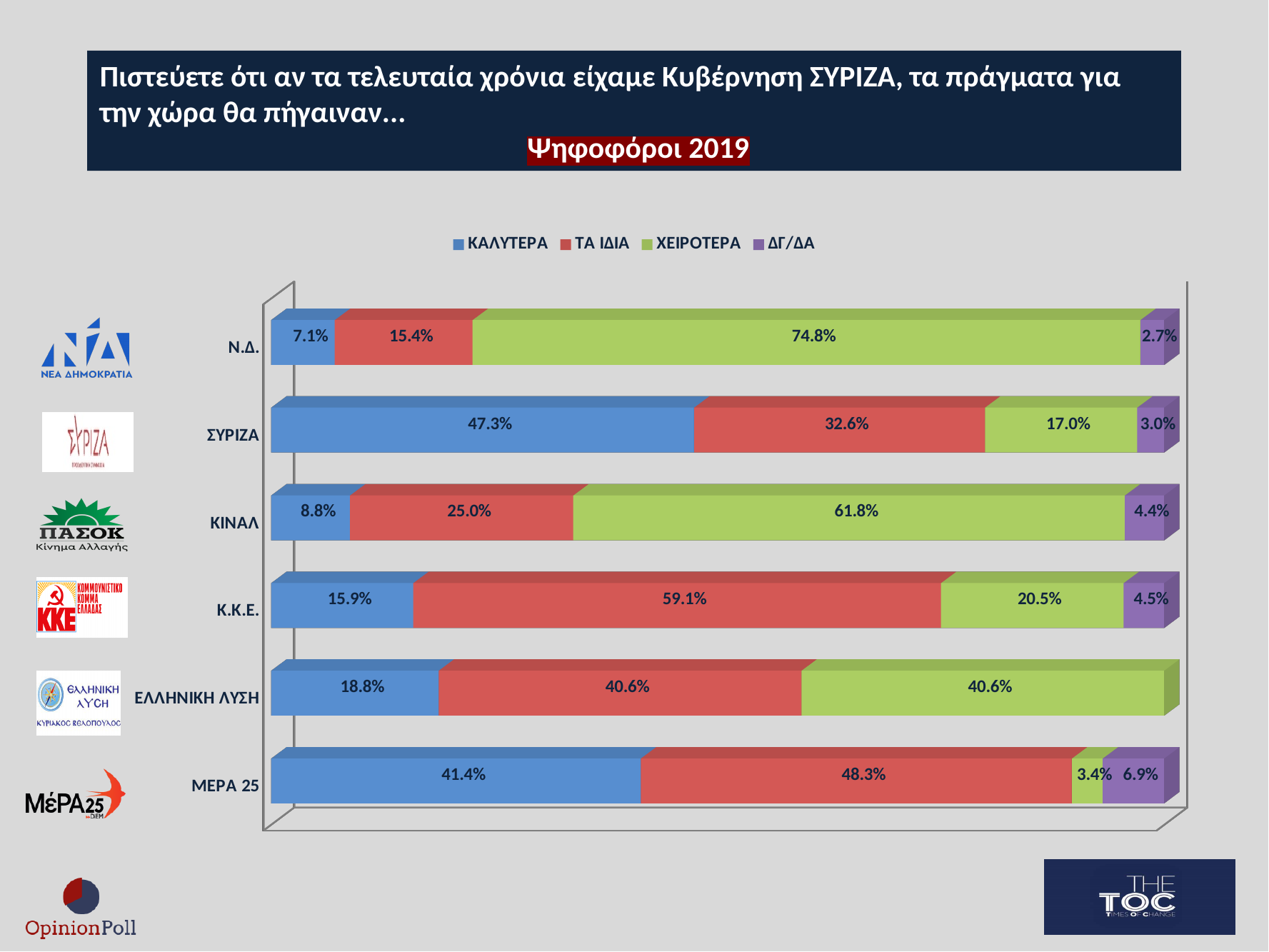
Which series is shown in green in the legend? ΧΕΙΡΟΤΕΡΑ What is the ΔΓ/ΔΑ value for ΜΕΡΑ 25? 6.9% Which party has the highest ΚΑΛΥΤΕΡΑ value? ΣΥΡΙΖΑ What is the difference between the ΧΕΙΡΟΤΕΡΑ values for Ν.Δ. and ΚΙΝΑΛ? 13.0% What is the ΧΕΙΡΟΤΕΡΑ value for Ν.Δ.? 74.8% How many parties (categories) are shown in the chart? 6 Which party has the lowest ΚΑΛΥΤΕΡΑ value? Ν.Δ. What kind of chart is shown on the slide? Stacked bar chart What is the ΚΑΛΥΤΕΡΑ value for ΣΥΡΙΖΑ? 47.3% How many series does the legend list? 4 Which is larger: the ΤΑ ΙΔΙΑ value for ΜΕΡΑ 25 or the ΤΑ ΙΔΙΑ value for ΣΥΡΙΖΑ? ΜΕΡΑ 25 What is the ΤΑ ΙΔΙΑ value for Κ.Κ.Ε.? 59.1%